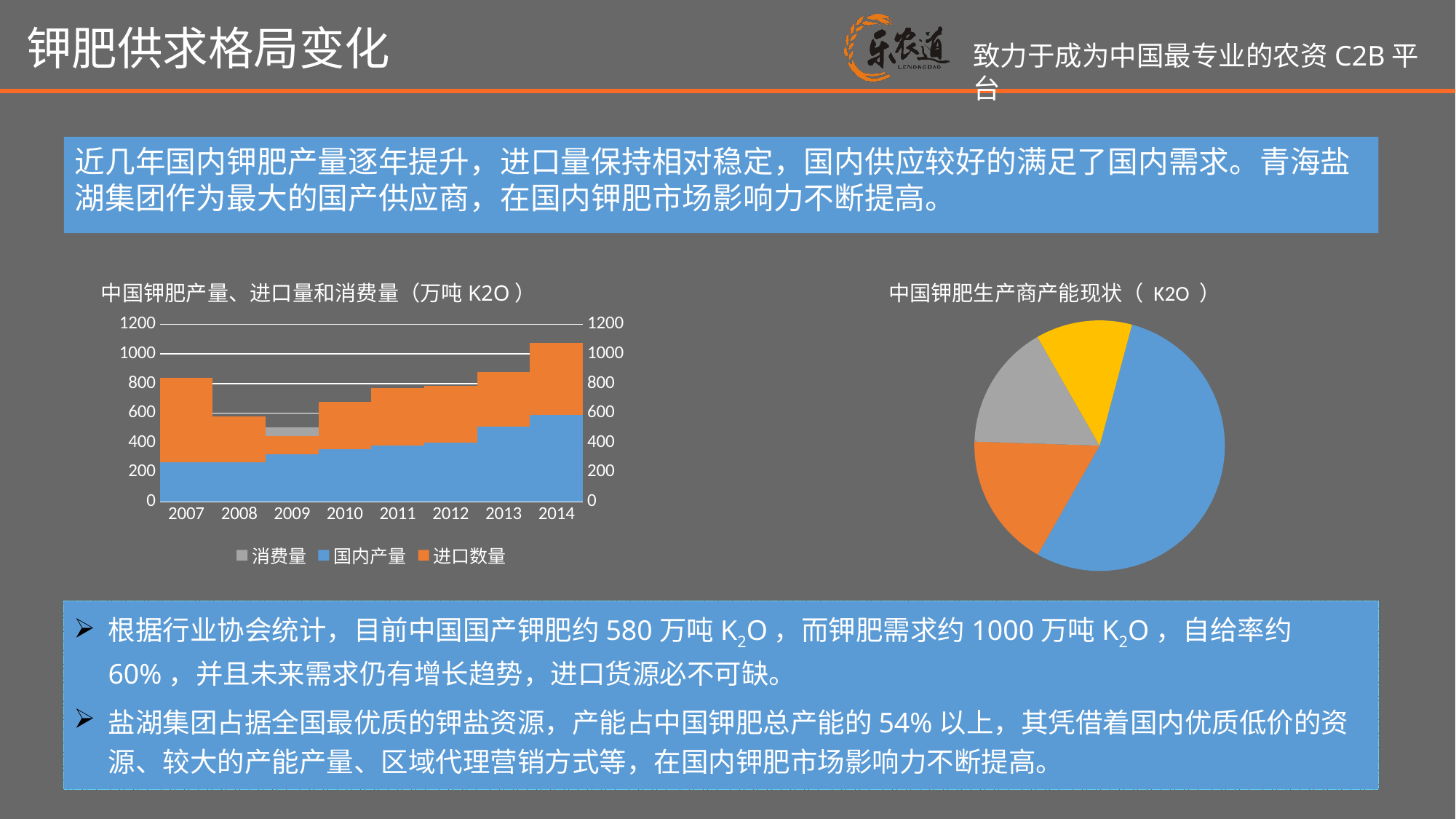
In the left chart 中国钾肥产量、进口量和消费量, is the total height of the stacked bar for 2014 greater or less than 1000? greater In the left chart 中国钾肥产量、进口量和消费量, is the 国内产量 value for 2014 greater or less than 400? greater What kind of chart is the right chart titled 中国钾肥生产商产能现状（ K2O ）? pie chart In the right chart 中国钾肥生产商产能现状, what colour is the largest slice? blue What kind of chart is the left chart titled 中国钾肥产量、进口量和消费量（万吨 K2O）? bar chart In the right chart 中国钾肥生产商产能现状, how many slices does the pie have? 4 In the left chart 中国钾肥产量、进口量和消费量, what is the highest value shown on the vertical axis? 1200 In the left chart 中国钾肥产量、进口量和消费量, how many years are shown on the x axis? 8 In the left chart 中国钾肥产量、进口量和消费量, which year has the tallest stacked bar? 2014 In the left chart 中国钾肥产量、进口量和消费量, is the 国内产量 value for 2007 greater or less than 400? less In the left chart 中国钾肥产量、进口量和消费量, how many series does the legend list? 3 In the left chart 中国钾肥产量、进口量和消费量, does the 国内产量 series rise or fall from 2007 to 2014? rise